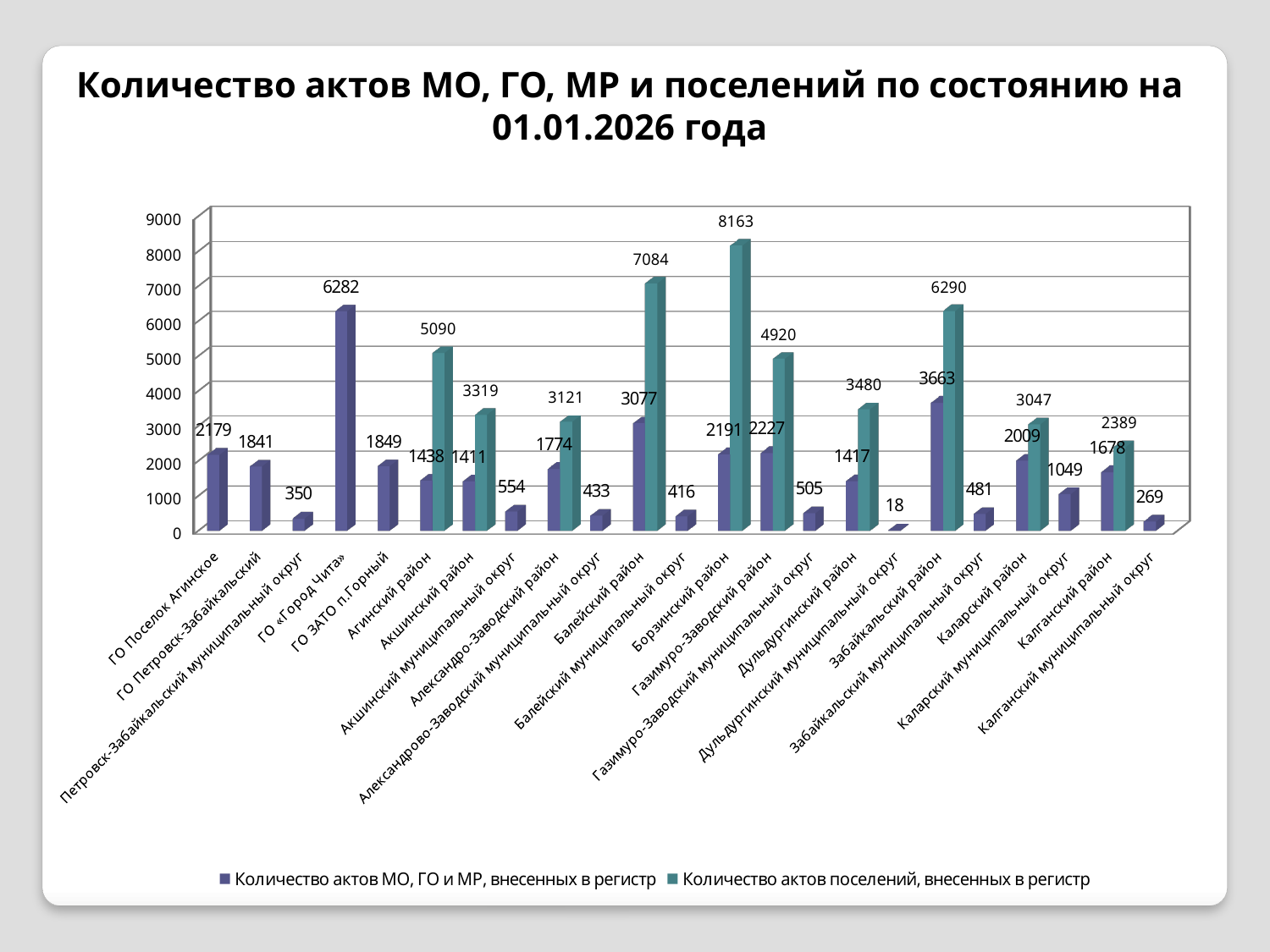
How many categories are shown on the x axis? 23 Which is larger: the 'Количество актов поселений, внесенных в регистр' value for Балейский район or for Забайкальский район? Балейский район What is the value of 'Количество актов МО, ГО и МР, внесенных в регистр' for Дульдургинский муниципальный округ? 18 What kind of chart is shown on the slide? Bar chart Which category has the highest value for 'Количество актов МО, ГО и МР, внесенных в регистр'? ГО «Город Чита» Which category has the highest value for 'Количество актов поселений, внесенных в регистр'? Борзинский район What is the value of 'Количество актов МО, ГО и МР, внесенных в регистр' for ГО «Город Чита»? 6282 What is the title of the chart? Количество актов МО, ГО, МР и поселений по состоянию на 01.01.2026 года What is the difference between the two series values for Борзинский район? 5972 Which category has the lowest value for 'Количество актов МО, ГО и МР, внесенных в регистр'? Дульдургинский муниципальный округ What is the value of 'Количество актов поселений, внесенных в регистр' for Борзинский район? 8163 How many series does the legend list? 2